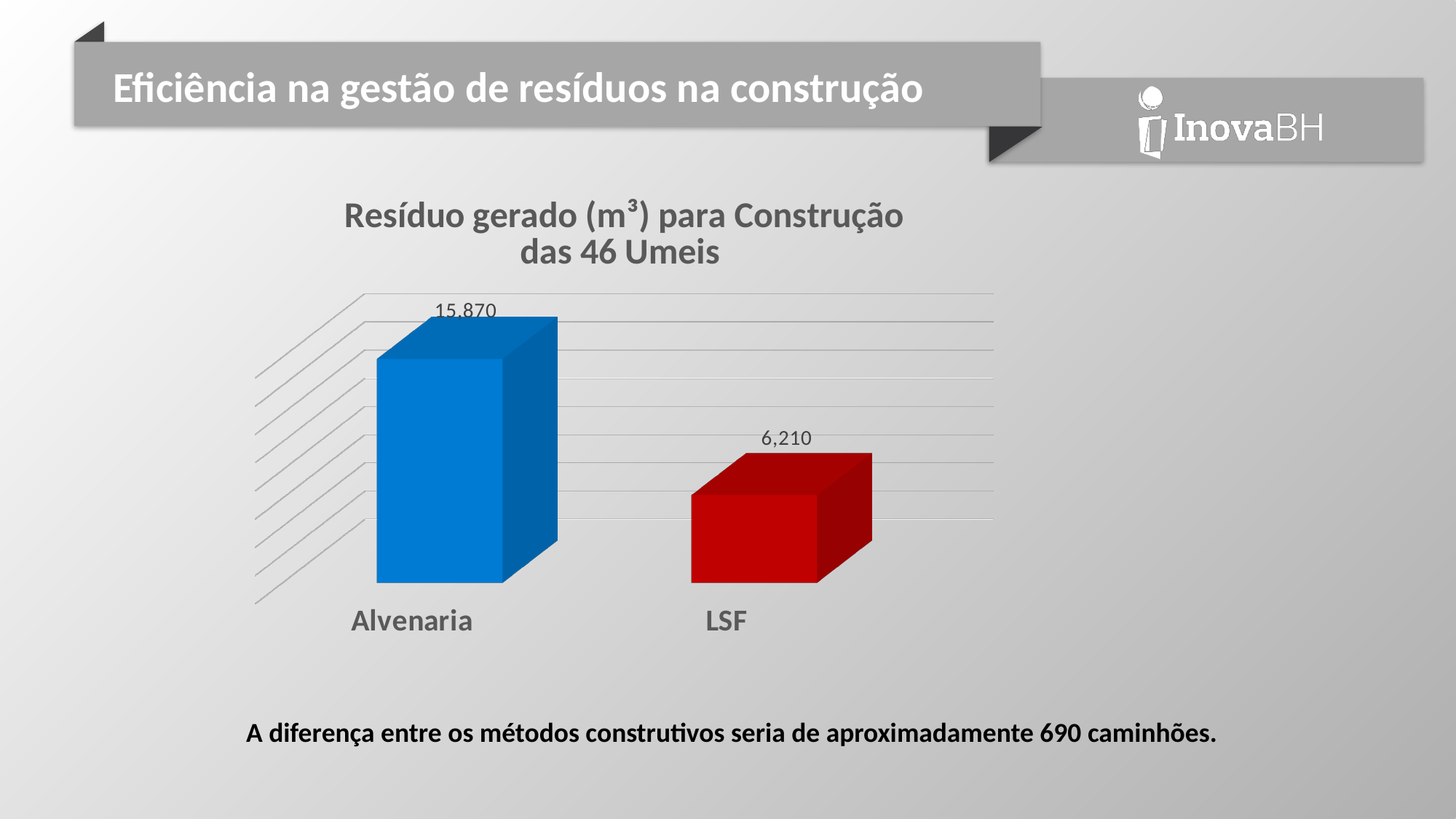
What kind of chart is shown on the slide? Bar chart Which category has the highest value? Alvenaria What is the title of the chart? Resíduo gerado (m³) para Construção das 46 Umeis Which category has the lowest value? LSF What is the value for LSF? 6,210 What is the value for Alvenaria? 15,870 What is the combined value of Alvenaria and LSF? 22,080 How many categories are shown in the chart? 2 What colour is the bar for LSF? Red Which is larger, the value for Alvenaria or the value for LSF? Alvenaria What is the difference between the values for Alvenaria and LSF? 9,660